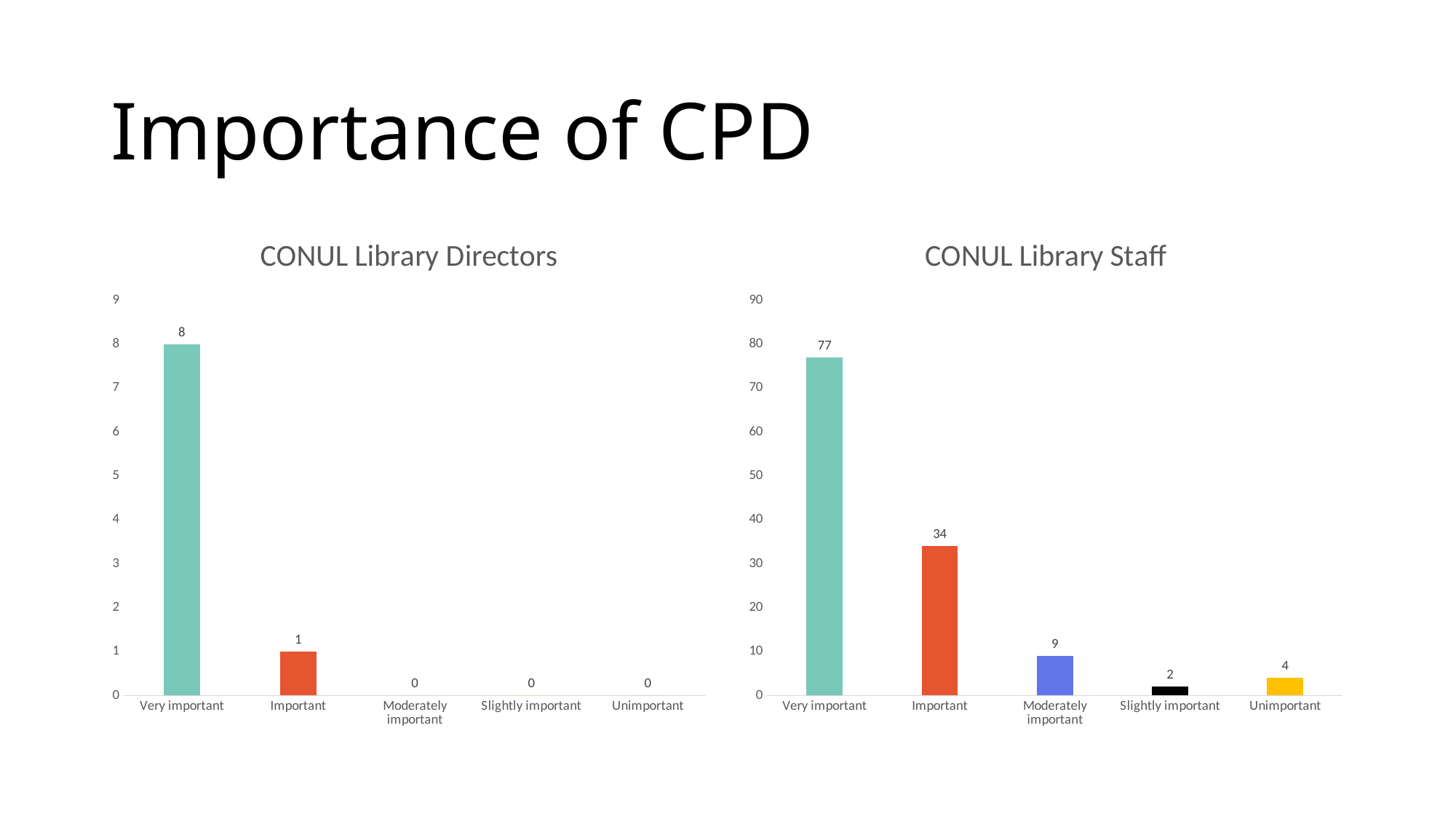
In the CONUL Library Directors chart, how many categories are shown on the x axis? 5 What kind of chart is the CONUL Library Staff chart? bar chart In the CONUL Library Directors chart, how many categories have a value of 0? 3 In the CONUL Library Directors chart, what is the value for Very important? 8 In the CONUL Library Staff chart, what is the value for Very important? 77 In the CONUL Library Staff chart, is the value for Important greater or less than 30? greater In the CONUL Library Staff chart, which category has the lowest value? Slightly important In the CONUL Library Staff chart, what is the difference between Very important and Important? 43 In the CONUL Library Staff chart, what is the value for Unimportant? 4 In the CONUL Library Directors chart, what is the value for Important? 1 In the CONUL Library Staff chart, which category has the highest value? Very important In the CONUL Library Staff chart, what is the value for Moderately important? 9